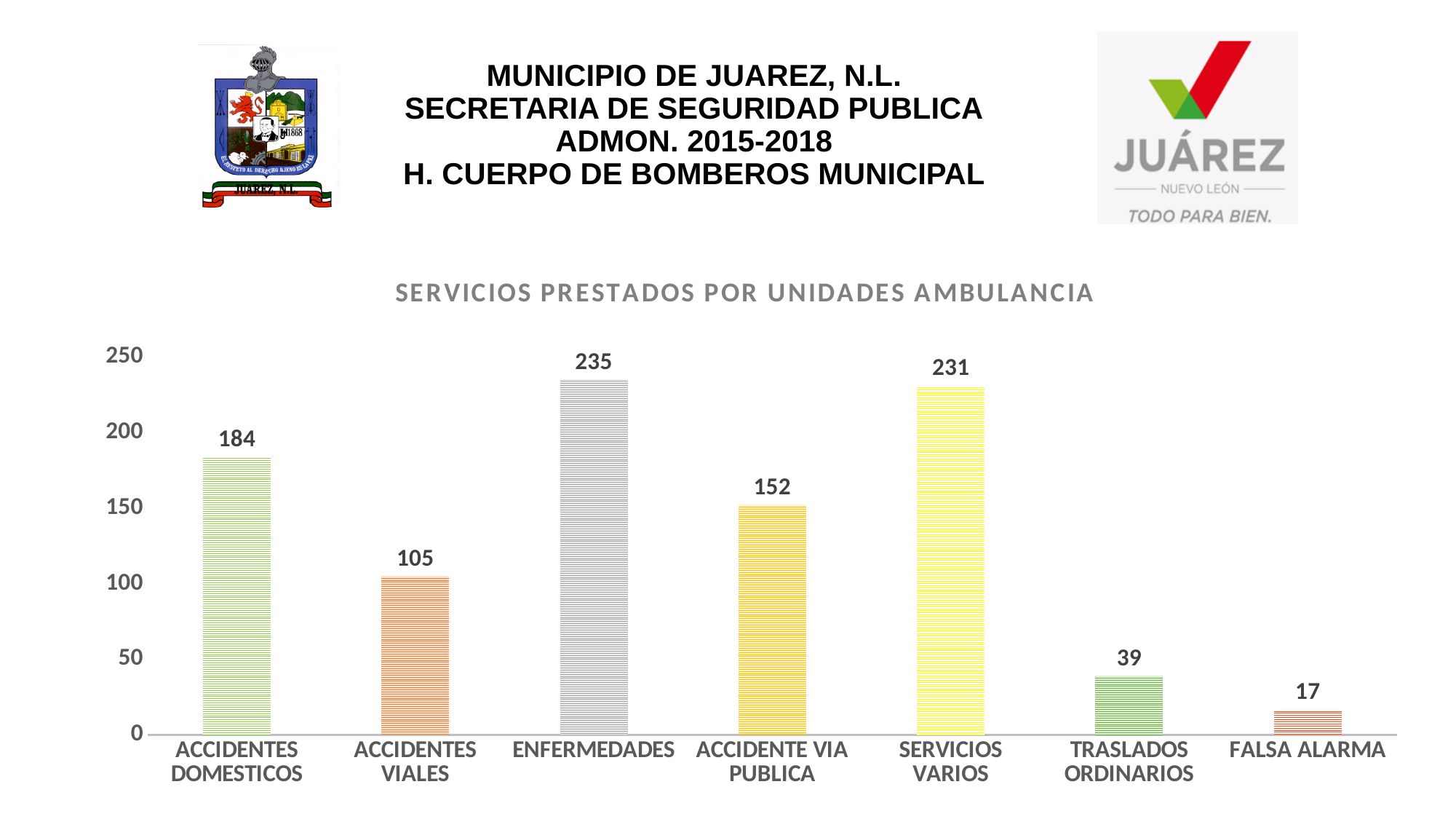
What kind of chart is shown on the slide? bar chart Which category has the lowest value? FALSA ALARMA Which is larger, the value for ACCIDENTES DOMESTICOS or the value for ACCIDENTE VIA PUBLICA? ACCIDENTES DOMESTICOS What is the title of the chart? SERVICIOS PRESTADOS POR UNIDADES AMBULANCIA What is the difference between the values for ACCIDENTES DOMESTICOS and ACCIDENTE VIA PUBLICA? 32 Which category has the highest value? ENFERMEDADES Is the value for ACCIDENTES VIALES greater or less than 100? greater How many categories are shown on the x axis? 7 What is the value for ACCIDENTES VIALES? 105 What is the difference between the values for SERVICIOS VARIOS and FALSA ALARMA? 214 What is the value for TRASLADOS ORDINARIOS? 39 What is the value for ENFERMEDADES? 235